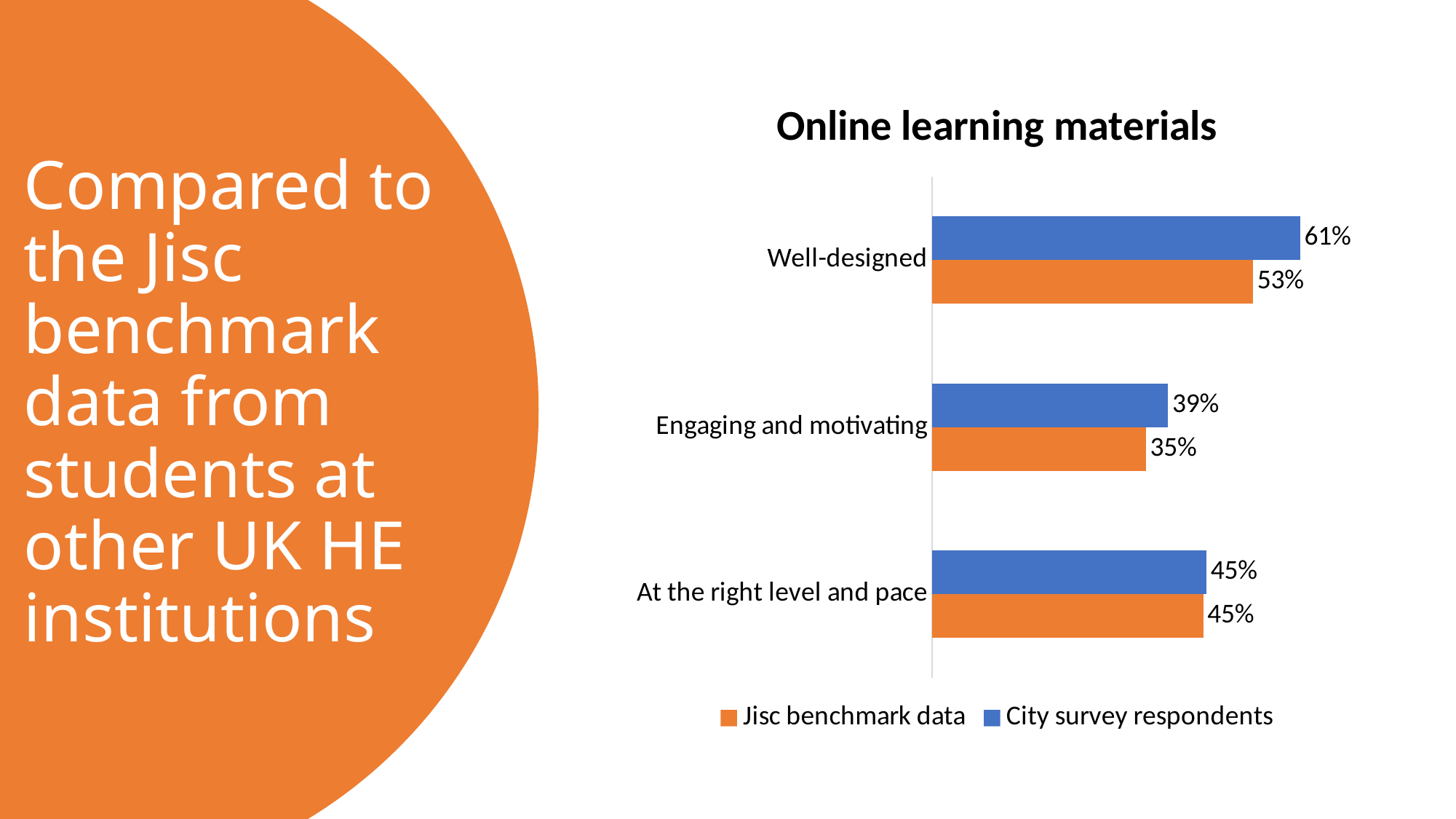
What kind of chart is shown on the slide? Bar chart What is the City survey respondents value for Well-designed? 61% Which category has the highest City survey respondents value? Well-designed What is the difference between the City survey respondents and Jisc benchmark data values for Engaging and motivating? 4% What is the title of the chart? Online learning materials Which is larger for Engaging and motivating: the City survey respondents value or the Jisc benchmark data value? City survey respondents How many categories are shown on the chart? 3 How many series does the legend list? 2 What is the difference between the City survey respondents and Jisc benchmark data values for Well-designed? 8% What is the Jisc benchmark data value for At the right level and pace? 45% What is the Jisc benchmark data value for Engaging and motivating? 35% Which category has the lowest Jisc benchmark data value? Engaging and motivating